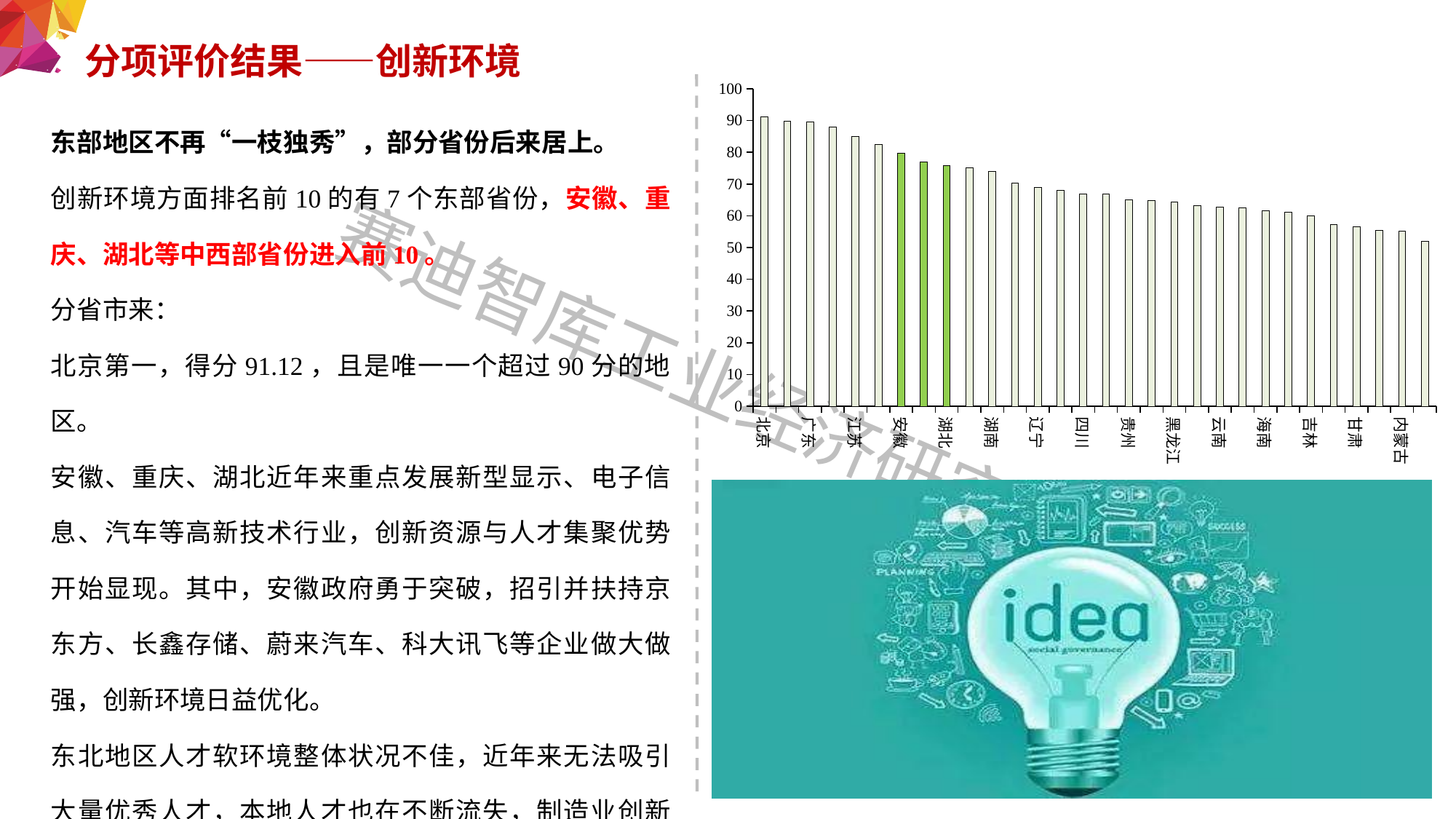
What kind of chart is shown on the slide? bar chart Is the value for 湖南 greater or less than 70? greater Do the bar values rise or fall from left to right along the x axis? fall Which has a larger value, 江苏 or 湖南? 江苏 Is the value for 内蒙古 greater or less than 50? greater Is the value for 北京 greater or less than 90? greater How many bars in the chart are highlighted in green? 3 Which labeled region has the lowest bar in the chart? 内蒙古 Which has a larger value, 北京 or 内蒙古? 北京 Which region has the highest bar in the chart? 北京